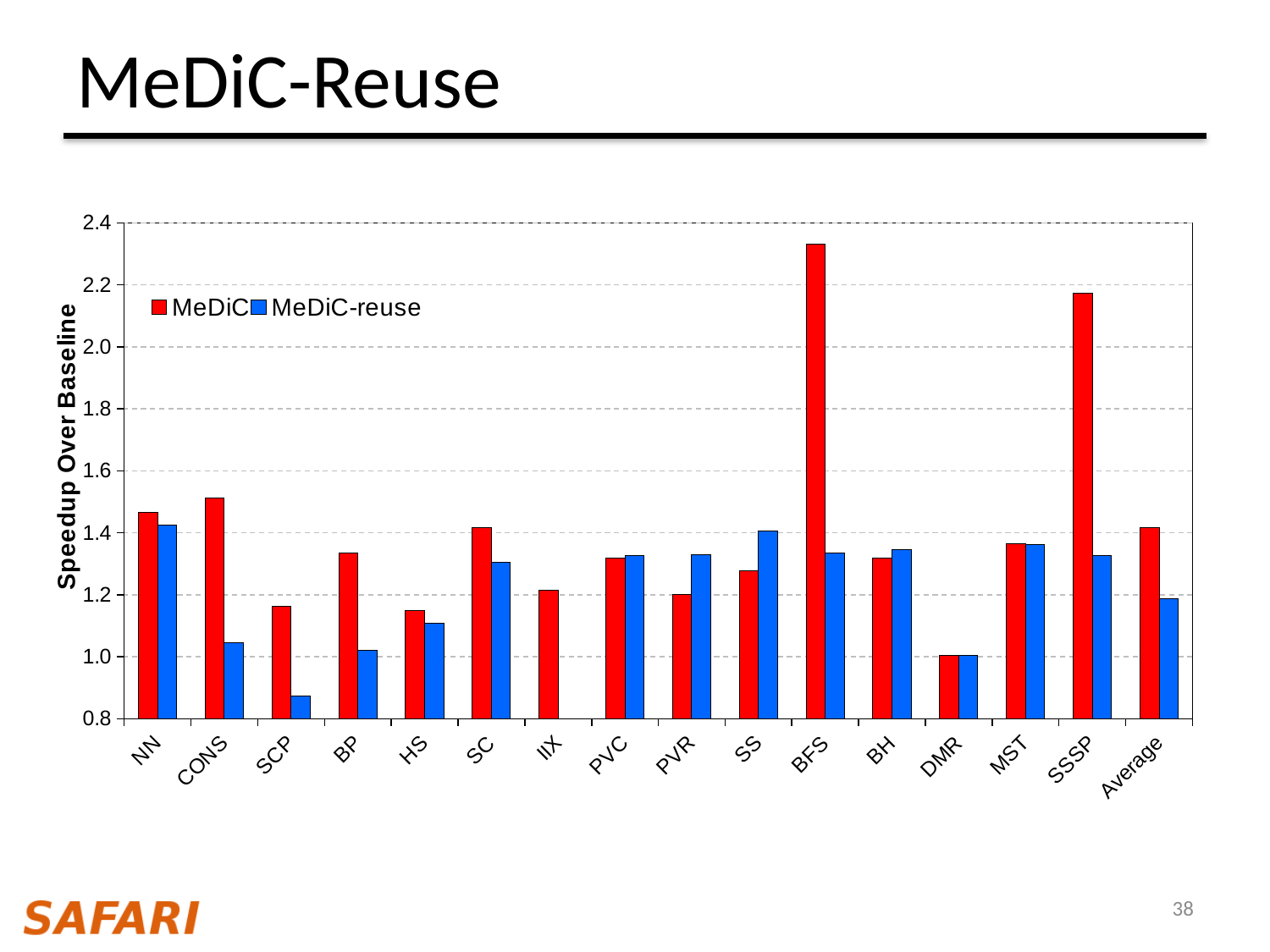
Which category has the highest MeDiC speedup? BFS Is the MeDiC value for BFS greater or less than 2.2? greater Is the MeDiC-reuse value for SCP greater or less than 1.0? less For SS, which is larger: the MeDiC value or the MeDiC-reuse value? MeDiC-reuse How many categories are shown on the x axis? 16 For CONS, which is larger: the MeDiC value or the MeDiC-reuse value? MeDiC Which category has the lowest MeDiC speedup? DMR Is the MeDiC value for Average greater or less than 1.2? greater What kind of chart is shown on the slide? bar chart What is the label of the y axis? Speedup Over Baseline How many series does the legend list? 2